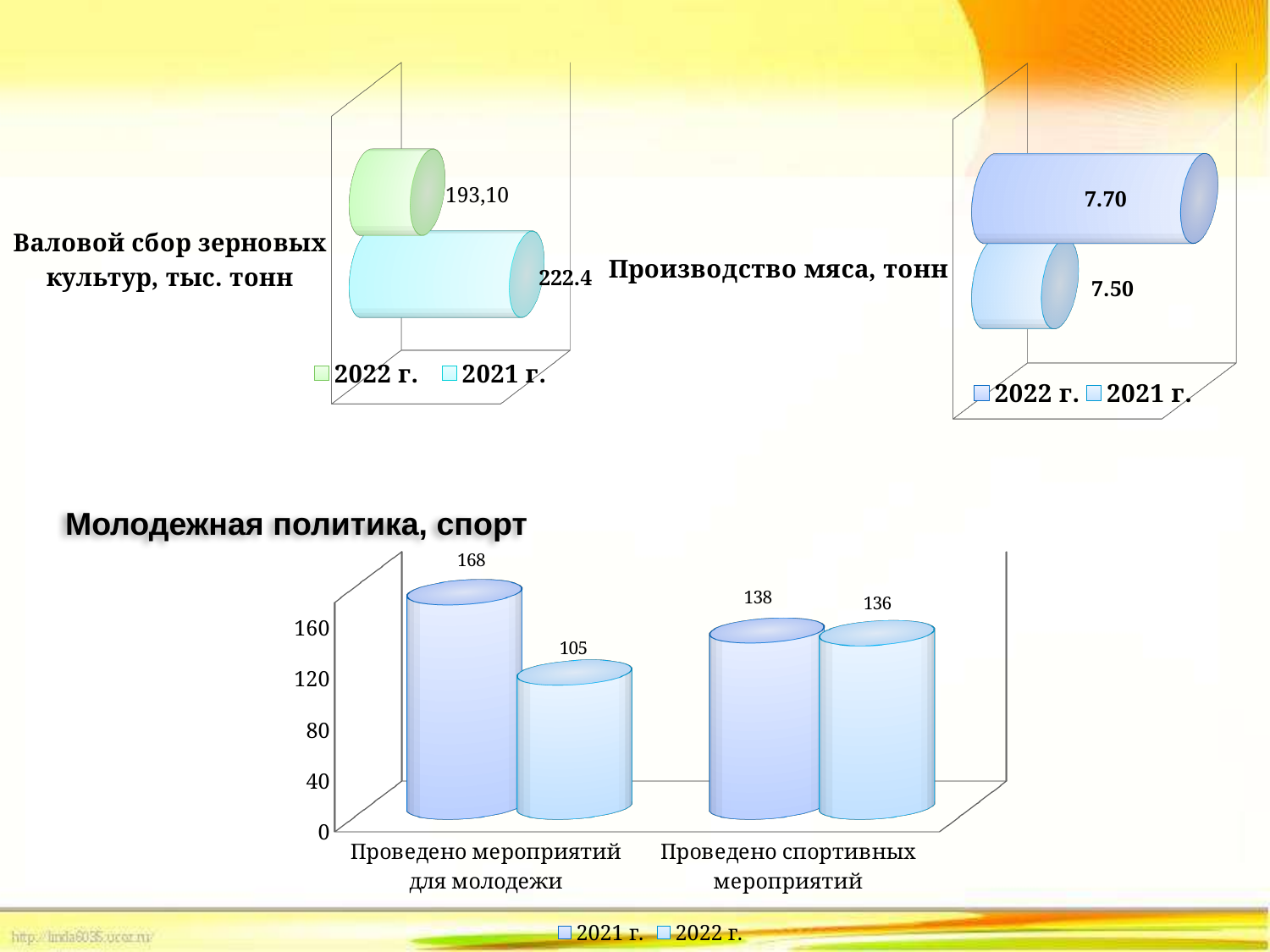
In the chart titled 'Молодежная политика, спорт', what is the difference between the 2021 г. and 2022 г. values for 'Проведено мероприятий для молодежи'? 63 In the chart titled 'Производство мяса, тонн', what is the value for 2021 г.? 7.50 In the chart titled 'Валовой сбор зерновых культур, тыс. тонн', what is the value for 2021 г.? 222.4 What kind of chart is the one titled 'Молодежная политика, спорт'? Bar chart In the chart titled 'Производство мяса, тонн', what is the difference between the 2022 г. and 2021 г. values? 0.20 In the chart titled 'Молодежная политика, спорт', how many series does the legend list? 2 In the chart titled 'Молодежная политика, спорт', what is the 2022 г. value for 'Проведено спортивных мероприятий'? 136 In the chart titled 'Производство мяса, тонн', what is the value for 2022 г.? 7.70 In the chart titled 'Молодежная политика, спорт', what is the 2021 г. value for 'Проведено мероприятий для молодежи'? 168 In the chart titled 'Молодежная политика, спорт', which bar is the highest? 2021 г., Проведено мероприятий для молодежи (168) In the chart titled 'Валовой сбор зерновых культур, тыс. тонн', what is the value for 2022 г.? 193,10 In the chart titled 'Валовой сбор зерновых культур, тыс. тонн', which year has the larger value, 2022 г. or 2021 г.? 2021 г.